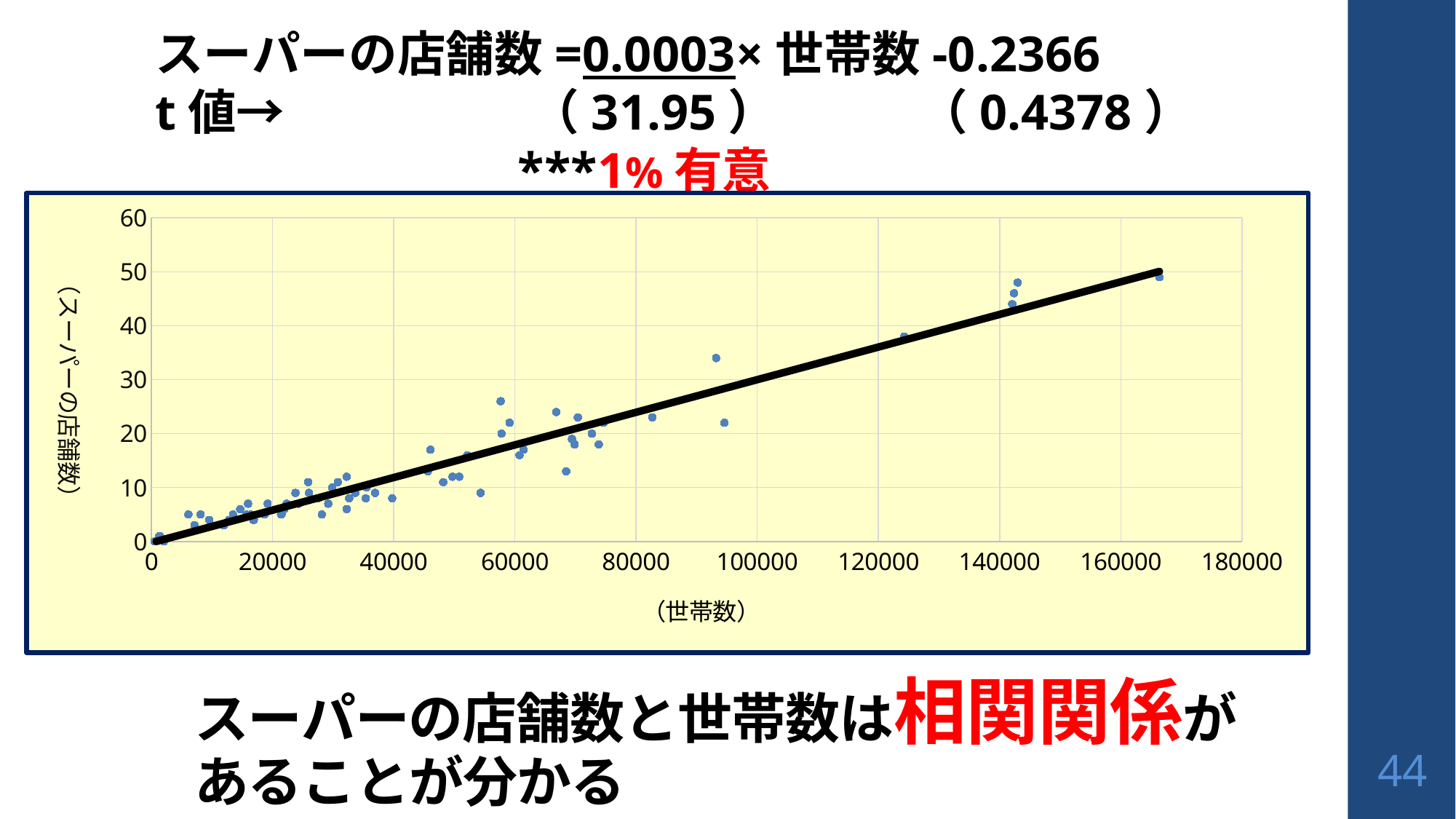
What is the highest tick value shown on the y axis? 60 What is the interval between consecutive tick marks on the y axis? 10 What is the label of the x axis of the chart? （世帯数） Do the plotted values rise or fall as the x axis (世帯数) increases? rise What is the highest tick value shown on the x axis? 180000 Is the y value of the point near x = 94000 that lies above the trend line greater or less than 30? greater Which is larger: the y value of the rightmost point (near x = 166000) or the y value of the point near x = 124000? the rightmost point (near x = 166000) Is the y value of the highest plotted point greater or less than 40? greater What is the label of the y axis of the chart? （スーパーの店舗数） Is the x value of the rightmost plotted point greater or less than 160000? greater What kind of chart is shown on the slide? scatter chart